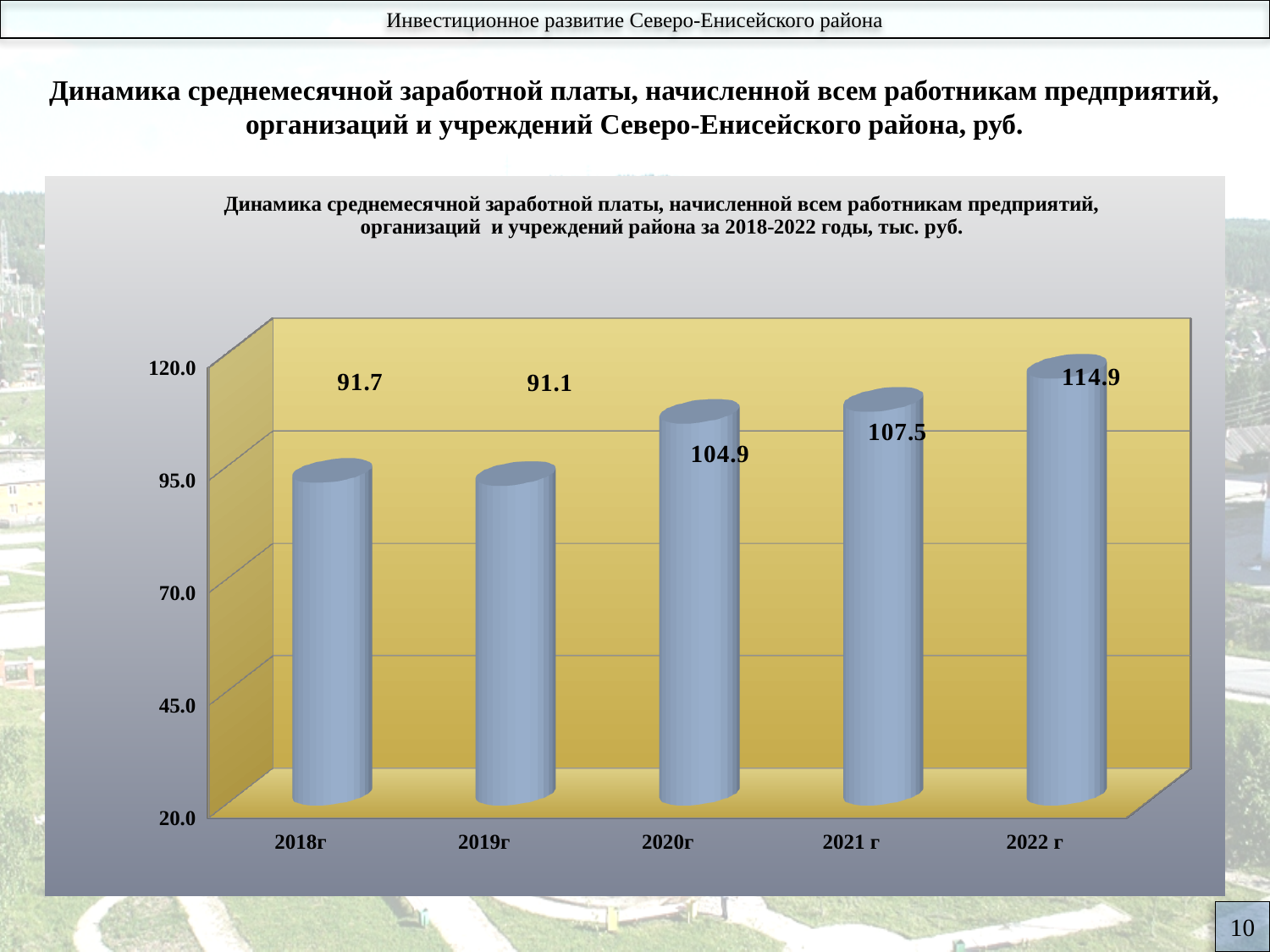
Which year has the highest value? 2022 г Which is larger, the value for 2020г or the value for 2021 г? 2021 г What is the value for 2018г? 91.7 What is the value for 2020г? 104.9 Do the values generally rise or fall from 2019г to 2022 г? rise How many years are shown on the x axis? 5 What is the difference between the values for 2021 г and 2020г? 2.6 What is the value for 2022 г? 114.9 What is the difference between the values for 2022 г and 2018г? 23.2 What kind of chart is this? bar chart Is the value for 2019г greater or less than 95.0? less Which year has the lowest value? 2019г